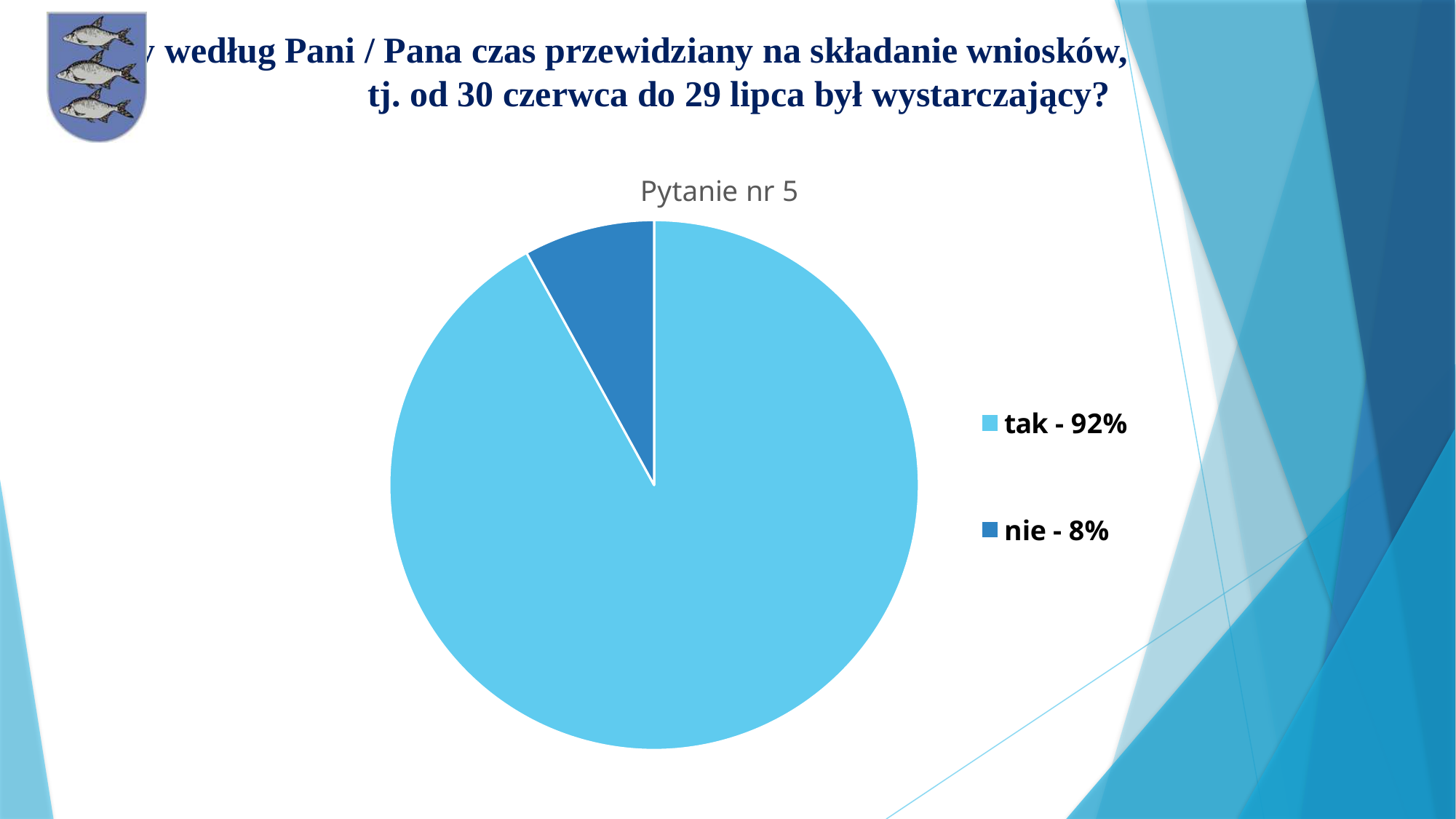
What is the combined share of the "tak" and "nie" slices? 100% What share of the pie does the "nie" slice represent? 8% How many slices does the pie chart have? 2 What is the difference in percentage points between the "tak" and "nie" slices? 84 Which slice is the largest in the pie chart? tak - 92% Which slice is the smallest in the pie chart? nie - 8% Which legend entry is shown in the darker blue colour? nie - 8% What kind of chart is shown on the slide? pie chart Which is larger, the "tak" slice or the "nie" slice? tak How many entries does the legend list? 2 What share of the pie does the "tak" slice represent? 92% What is the title of the chart? Pytanie nr 5